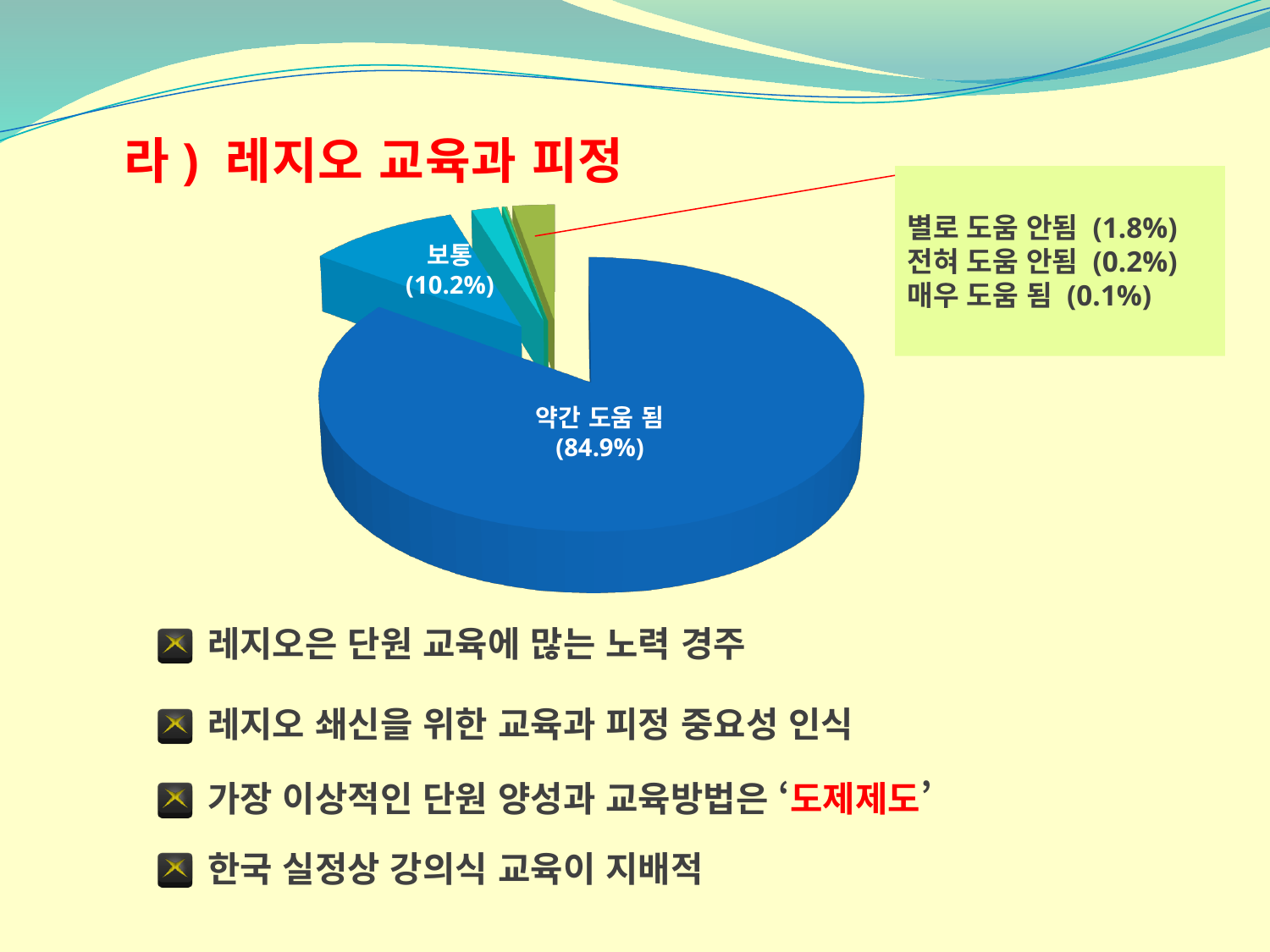
What kind of chart is shown on the slide? pie chart What percentage is shown for 전혀 도움 안됨? 0.2% What percentage is shown for 별로 도움 안됨? 1.8% Which is larger, the share for 별로 도움 안됨 or the share for 전혀 도움 안됨? 별로 도움 안됨 What is the title of the slide containing the chart? 라 ) 레지오 교육과 피정 Which category has the smallest share of the pie? 매우 도움 됨 Which category has the largest share of the pie? 약간 도움 됨 What percentage is shown for 보통? 10.2% What is the difference in percentage points between 약간 도움 됨 and 보통? 74.7 What percentage is shown for 매우 도움 됨? 0.1% What percentage is shown for 약간 도움 됨? 84.9%